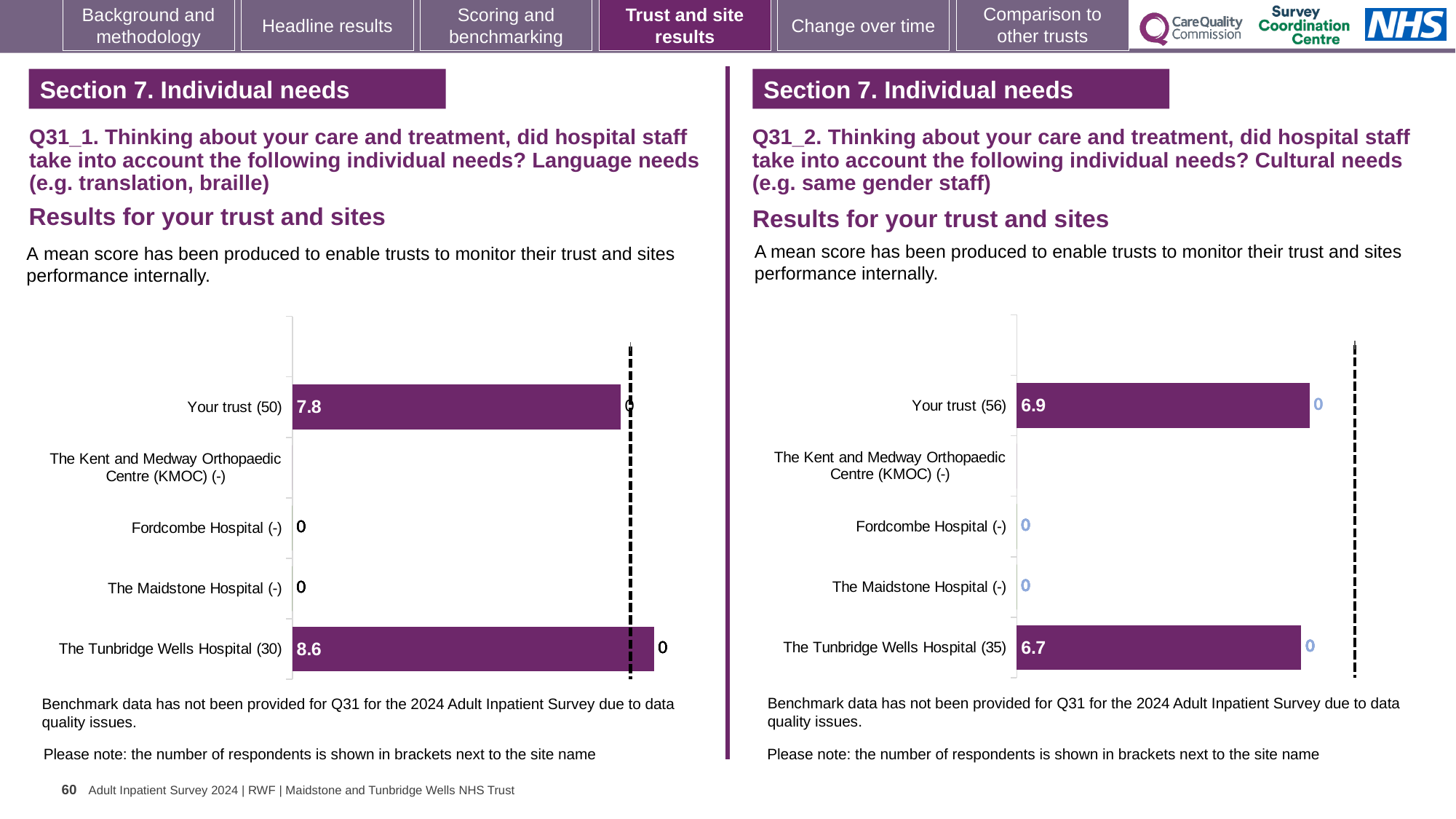
On the right chart (Q31_2, Cultural needs), what is the mean score for Your trust (56)? 6.9 On the right chart (Q31_2, Cultural needs), what is the mean score for The Tunbridge Wells Hospital (35)? 6.7 How many categories are listed on the left chart (Q31_1, Language needs)? 5 On the right chart (Q31_2, Cultural needs), which has the higher mean score: Your trust (56) or The Tunbridge Wells Hospital (35)? Your trust (56) What type of chart is used on the right side of the slide (Q31_2, Cultural needs)? Bar chart On the left chart (Q31_1, Language needs), what is the mean score for The Tunbridge Wells Hospital (30)? 8.6 On the left chart (Q31_1, Language needs), which site has the highest mean score? The Tunbridge Wells Hospital (30) On the left chart (Q31_1, Language needs), what is the mean score for Your trust (50)? 7.8 On the left chart (Q31_1, Language needs), how many respondents are shown in brackets for The Tunbridge Wells Hospital? 30 On the right chart (Q31_2, Cultural needs), what is the difference between the scores for Your trust (56) and The Tunbridge Wells Hospital (35)? 0.2 On the left chart (Q31_1, Language needs), what is the difference between the scores for The Tunbridge Wells Hospital (30) and Your trust (50)? 0.8 On the right chart (Q31_2, Cultural needs), how many respondents are shown in brackets for Your trust? 56